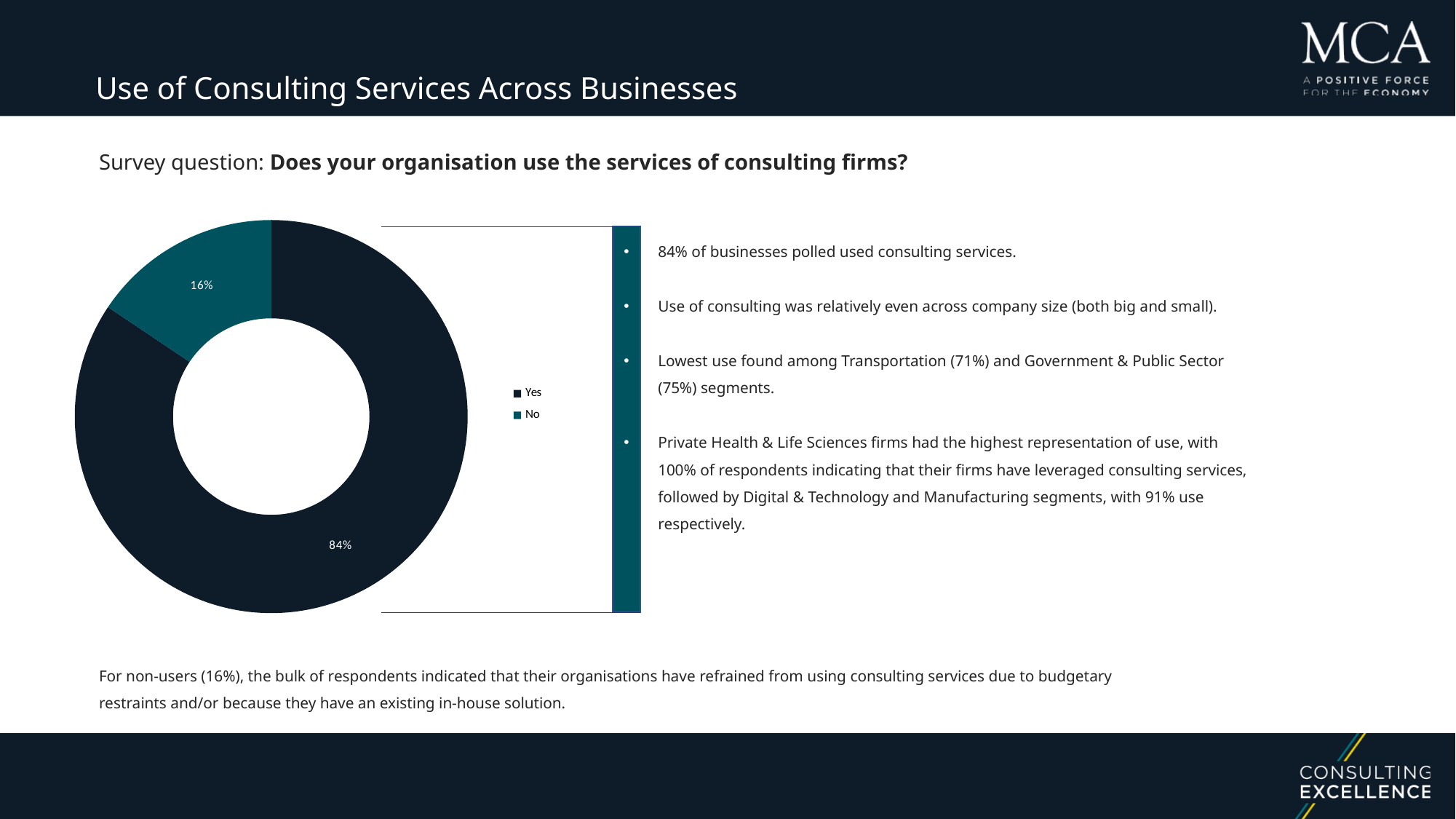
What kind of chart is shown on the slide? Doughnut chart Which slice is larger, "Yes" or "No"? Yes What share of the pie does the "No" slice represent? 16% Which category has the smallest share of the pie chart? No How many categories does the pie chart show? 2 What are the two entries listed in the chart legend? Yes and No Which category has the largest share of the pie chart? Yes What colour is the "No" slice in the pie chart? Teal Is the share for "Yes" greater or less than 50%? greater What is the difference in percentage points between the "Yes" and "No" slices? 68 What percentage of the pie chart is labelled "No"? 16% What percentage of the pie chart is labelled "Yes"? 84%